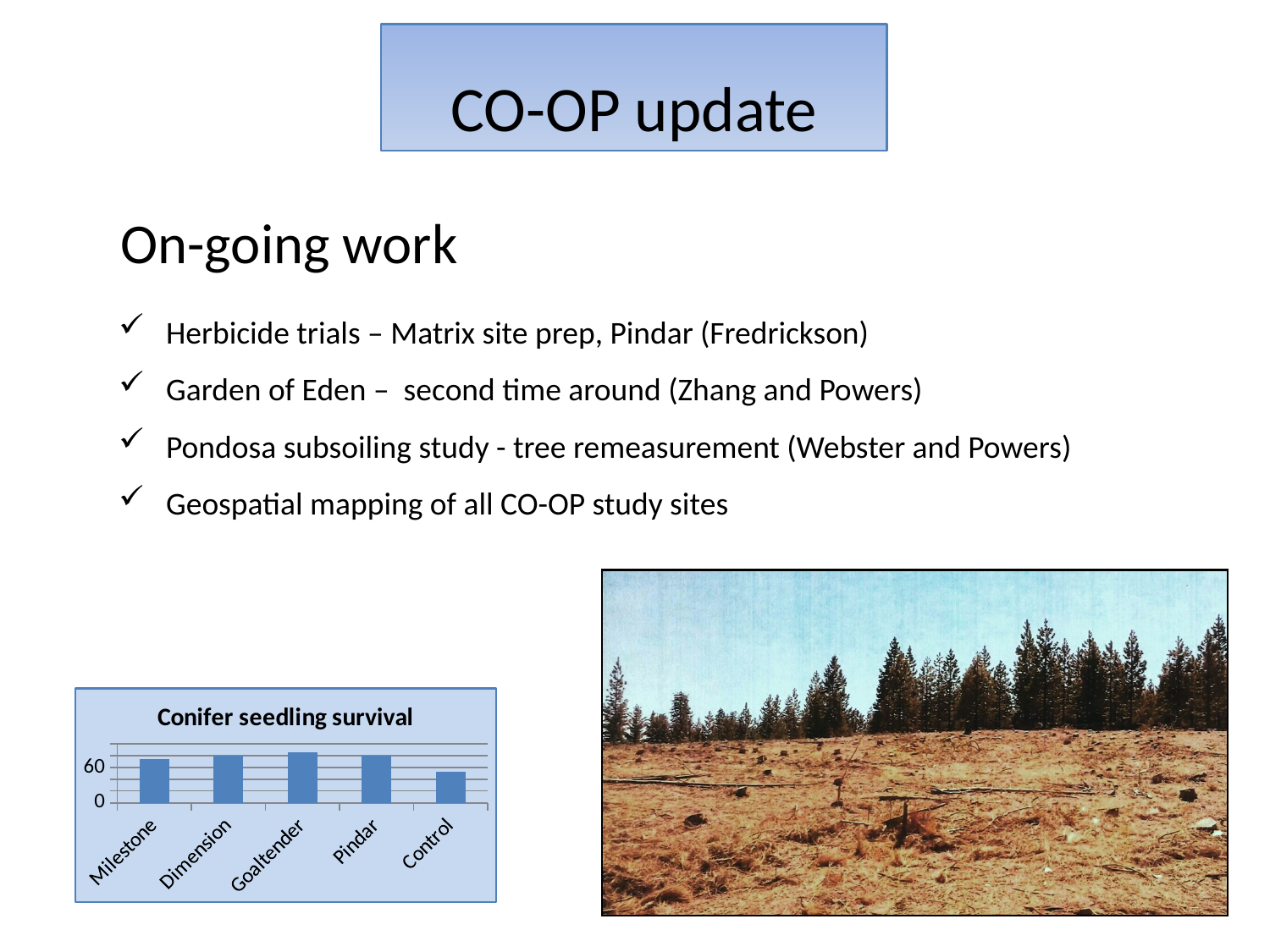
In the Conifer seedling survival chart, which is larger, the value for Milestone or the value for Control? Milestone Which category has the lowest value in the Conifer seedling survival chart? Control How many categories are shown on the x axis of the Conifer seedling survival chart? 5 What type of chart is shown on the slide? bar chart Which category has the highest value in the Conifer seedling survival chart? Goaltender Which category is listed last on the x axis of the Conifer seedling survival chart? Control What is the title of the chart on the slide? Conifer seedling survival Is the value for Pindar in the Conifer seedling survival chart greater or less than 60? greater In the Conifer seedling survival chart, which is larger, the value for Goaltender or the value for Control? Goaltender Which category is listed first on the x axis of the Conifer seedling survival chart? Milestone Is the value for Goaltender in the Conifer seedling survival chart greater or less than 60? greater